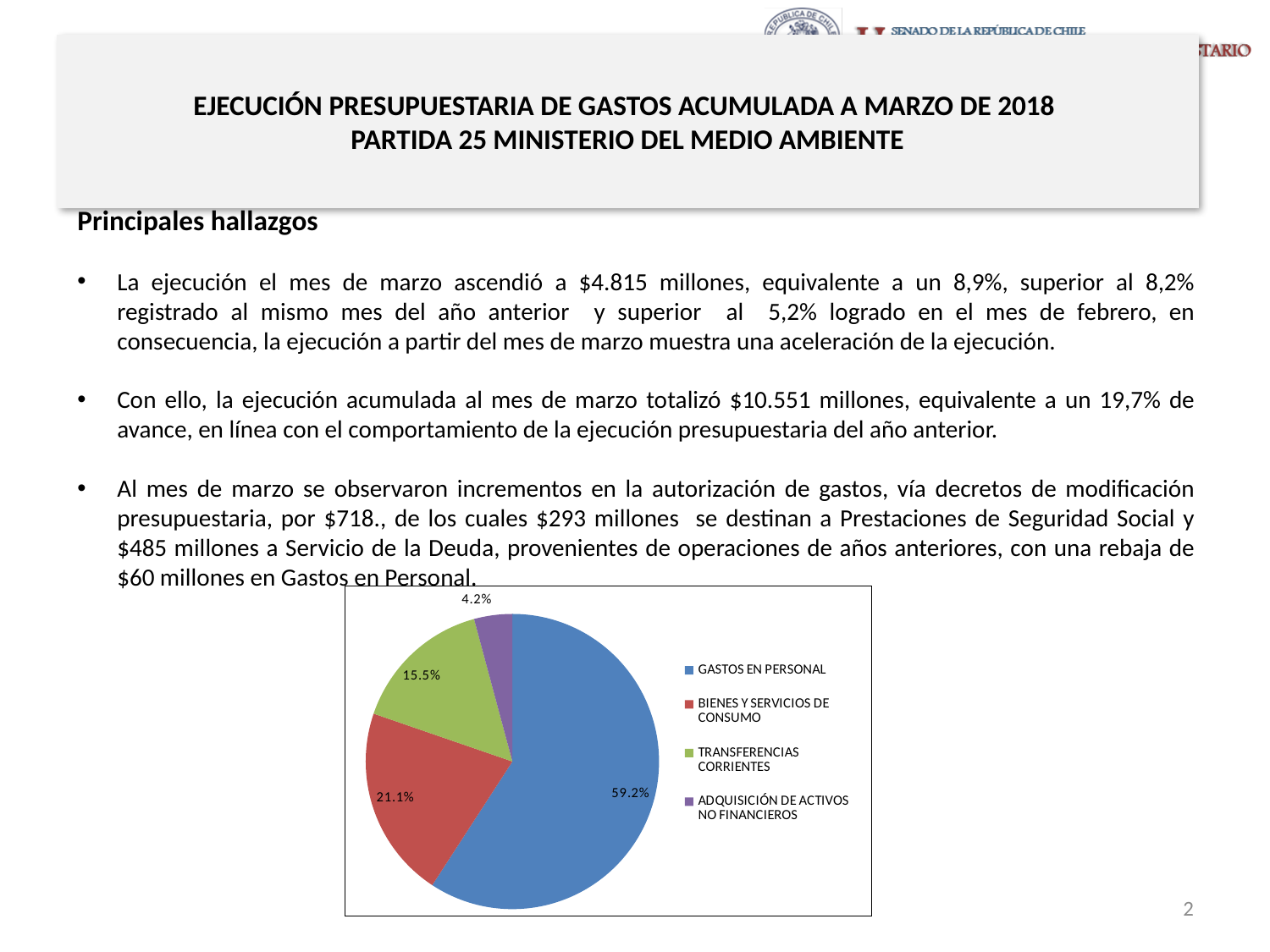
What share of the pie does ADQUISICIÓN DE ACTIVOS NO FINANCIEROS represent? 4.2% What colour is the slice for TRANSFERENCIAS CORRIENTES? green What kind of chart is shown on the slide? pie chart What share of the pie does TRANSFERENCIAS CORRIENTES represent? 15.5% Which category has the largest slice of the pie? GASTOS EN PERSONAL What share of the pie does GASTOS EN PERSONAL represent? 59.2% Which category has the smallest slice of the pie? ADQUISICIÓN DE ACTIVOS NO FINANCIEROS What is the difference in percentage points between the TRANSFERENCIAS CORRIENTES slice and the ADQUISICIÓN DE ACTIVOS NO FINANCIEROS slice? 11.3 Which slice is larger, TRANSFERENCIAS CORRIENTES or BIENES Y SERVICIOS DE CONSUMO? BIENES Y SERVICIOS DE CONSUMO What is the difference in percentage points between the GASTOS EN PERSONAL slice and the BIENES Y SERVICIOS DE CONSUMO slice? 38.1 How many categories does the pie chart show? 4